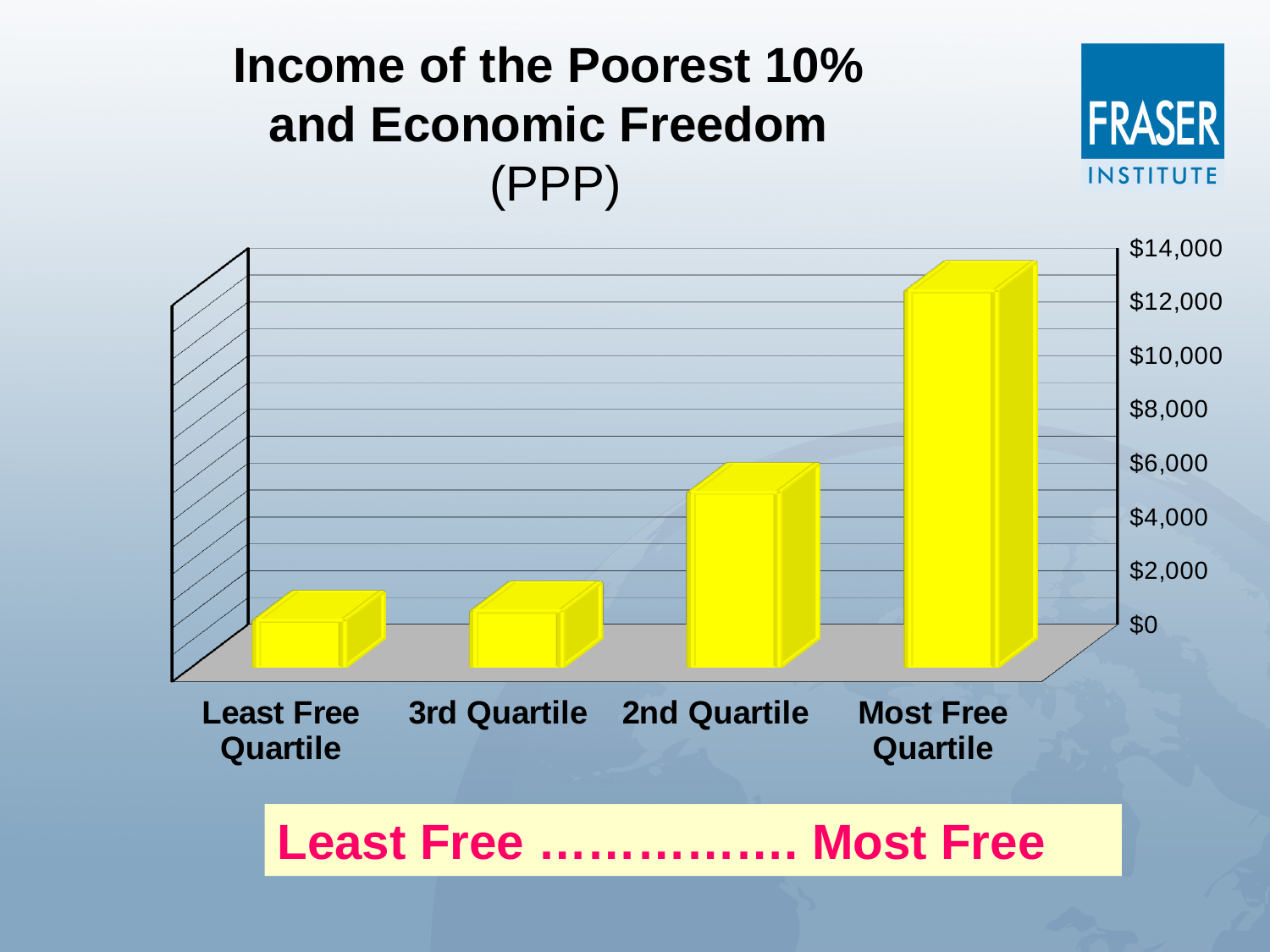
Which quartile has the highest income of the poorest 10%? Most Free Quartile Is the value for the 2nd Quartile greater or less than $4,000? greater Do the values rise or fall moving from the Least Free Quartile to the Most Free Quartile? rise What is the title of the chart? Income of the Poorest 10% and Economic Freedom (PPP) Which quartile has the lowest income of the poorest 10%? Least Free Quartile What kind of chart is shown on the slide? bar chart Is the value for the Least Free Quartile greater or less than $2,000? less How many quartile categories are plotted in the chart? 4 Which is larger, the value for the 2nd Quartile or the 3rd Quartile? 2nd Quartile Is the value for the Most Free Quartile greater or less than $12,000? greater